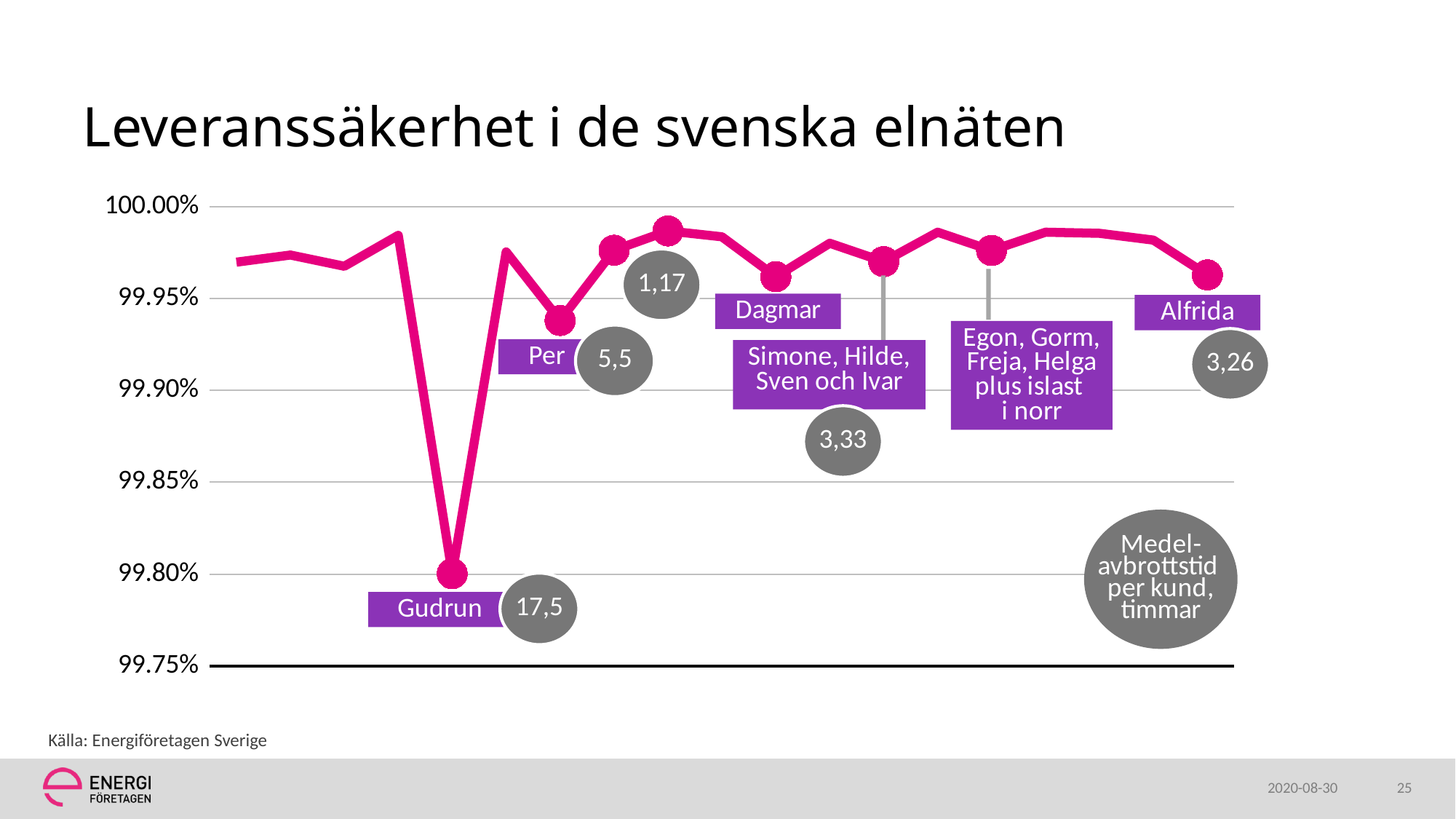
Is the value at the Gudrun point greater or less than 99.85%? less Which labelled storm corresponds to the lowest point on the line? Gudrun What kind of chart is shown on the slide? line chart Is the value at the Per point greater or less than 99.95%? less What is the title of the slide containing the chart? Leveranssäkerhet i de svenska elnäten What is the highest value shown on the y axis of the chart? 100.00% Is the value at the Dagmar point greater or less than 99.90%? greater What average outage time per customer (in hours) is shown in the grey circle next to Per? 5,5 What average outage time per customer (in hours) is shown in the grey circle next to Gudrun? 17,5 What average outage time per customer (in hours) is shown in the grey circle below Alfrida? 3,26 Which has the larger average outage time per customer, Gudrun or Per? Gudrun